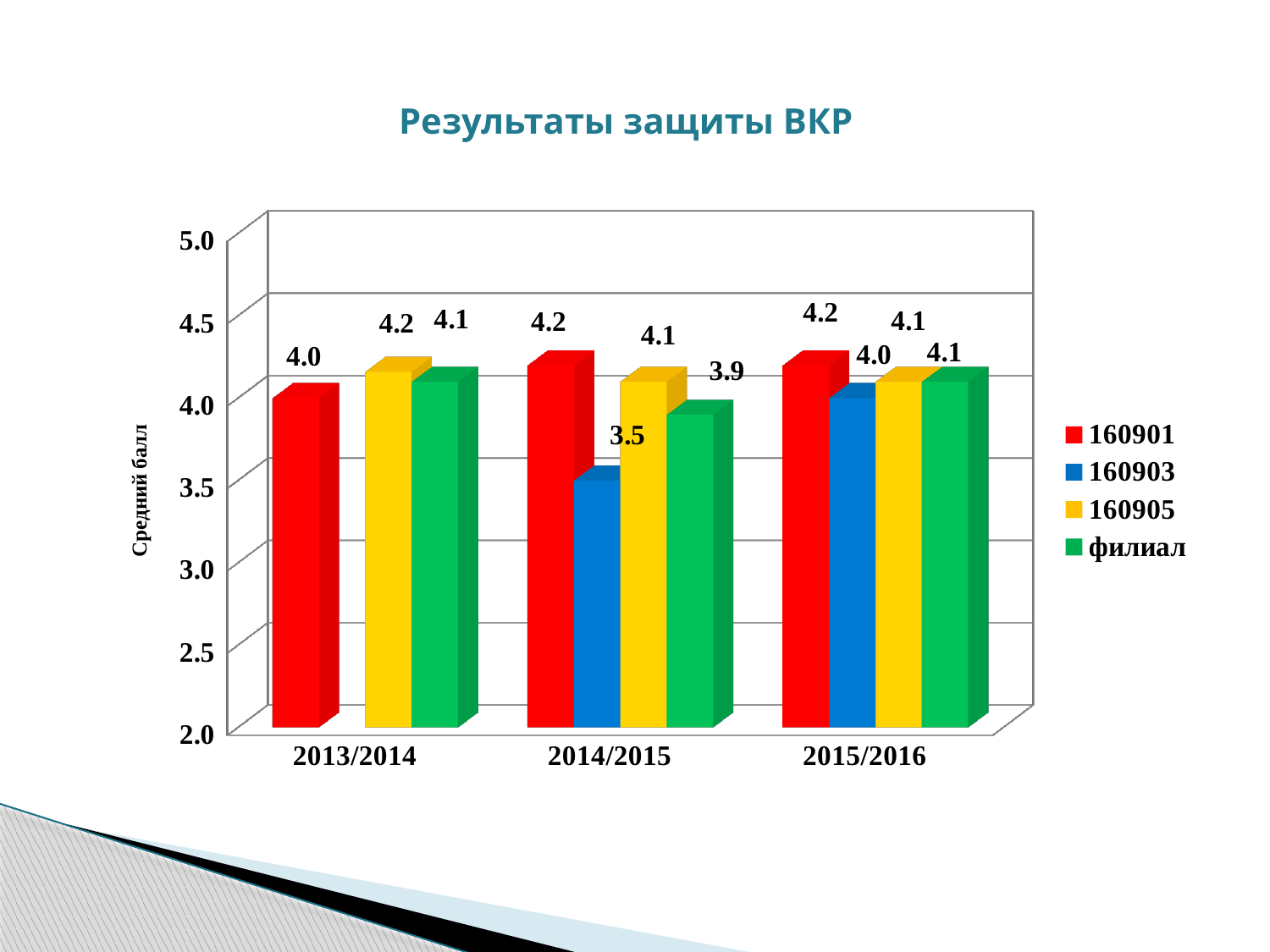
What kind of chart is shown on the slide? Bar chart What is the value for филиал in 2014/2015? 3.9 Which is larger in 2014/2015: the value for 160905 or the value for филиал? 160905 How many series does the legend list? 4 What is the value for 160905 in 2015/2016? 4.1 Which series has the highest value in 2013/2014? 160905 What is the title of the chart? Результаты защиты ВКР What is the value for 160903 in 2014/2015? 3.5 What is the value for 160901 in 2013/2014? 4.0 How many categories are shown on the x axis? 3 What is the difference between the 160901 and 160903 values in 2014/2015? 0.7 Which series has the lowest value in 2014/2015? 160903